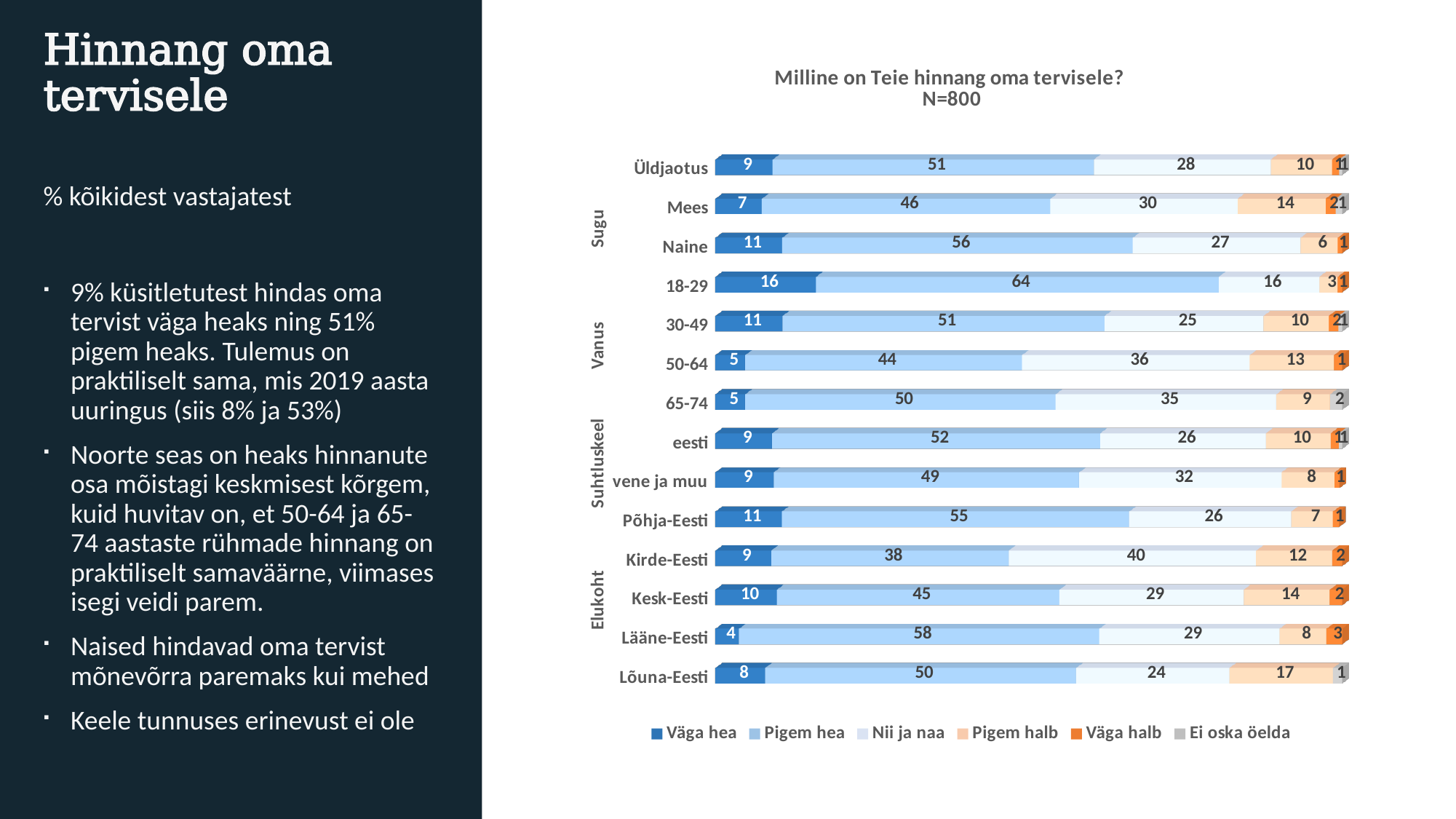
What is the 'Pigem hea' value for Naine? 56 What is the 'Väga hea' value for the 18-29 age group? 16 What is the 'Nii ja naa' value for Kirde-Eesti? 40 How many series does the legend list? 6 What kind of chart is shown on the slide? stacked bar chart Which category has the lowest 'Väga hea' value? Lääne-Eesti How many categories (bars) are plotted in the chart? 14 What is the difference between the 'Pigem hea' values for Naine and Mees? 10 What is the title of the chart? Milline on Teie hinnang oma tervisele? N=800 Which category has the highest 'Väga hea' value? 18-29 Which has the larger 'Nii ja naa' value, Kirde-Eesti or Lõuna-Eesti? Kirde-Eesti What is the 'Pigem halb' value for Lõuna-Eesti? 17